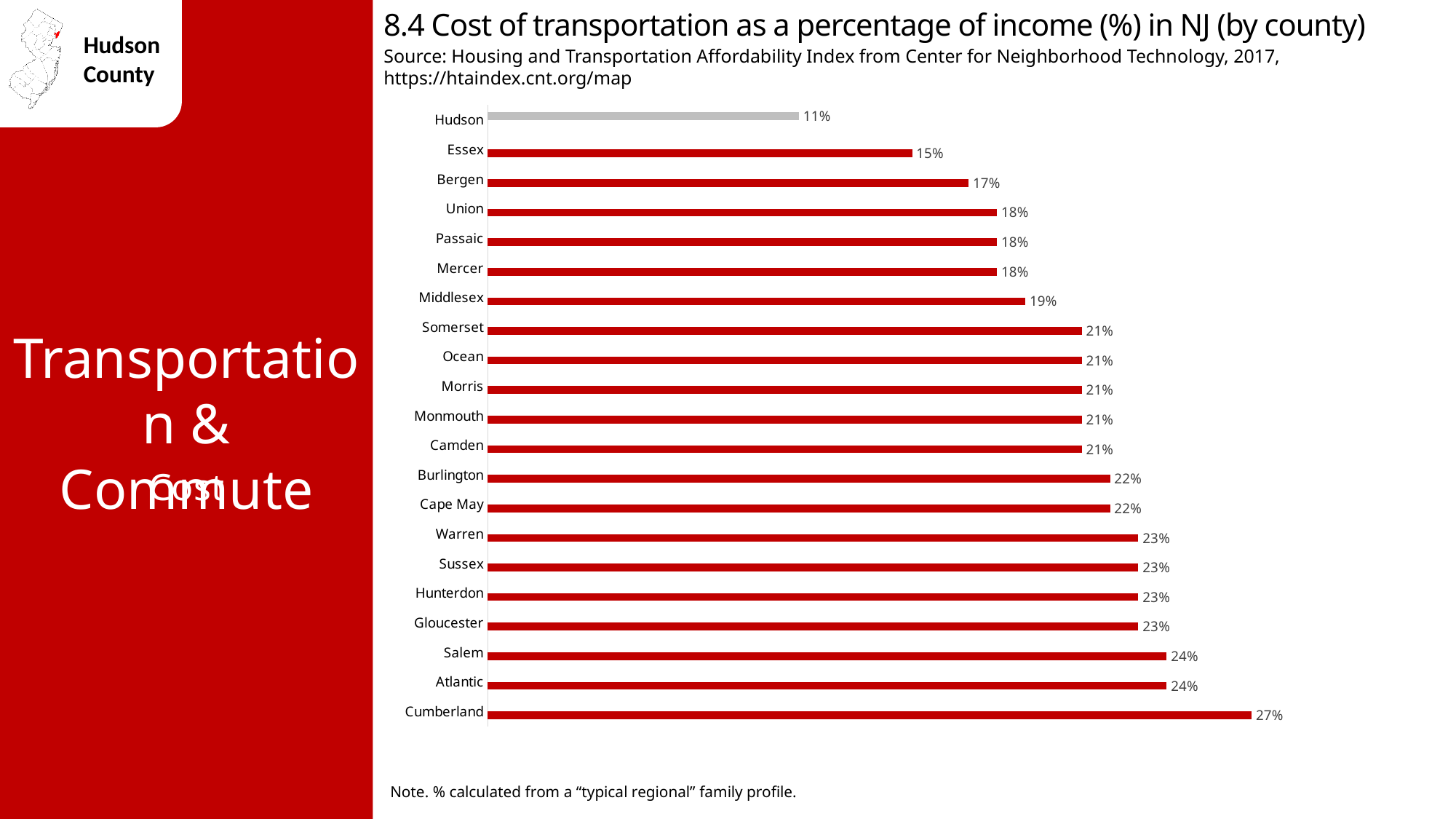
Do the values rise or fall going from the top bar (Hudson) to the bottom bar (Cumberland)? Rise How many counties are shown in the chart? 21 Which has a higher value, Salem or Warren? Salem What is the cost of transportation as a percentage of income for Hudson County? 11% Which county's bar is coloured grey instead of red? Hudson What is the difference between the values for Cumberland and Hudson? 16% Which county has the highest cost of transportation as a percentage of income? Cumberland What is the difference between the values for Bergen and Essex? 2% What kind of chart is shown on the slide? Bar chart Which county has the lowest cost of transportation as a percentage of income? Hudson What is the value shown for Cumberland County? 27% What is the value shown for Middlesex County? 19%